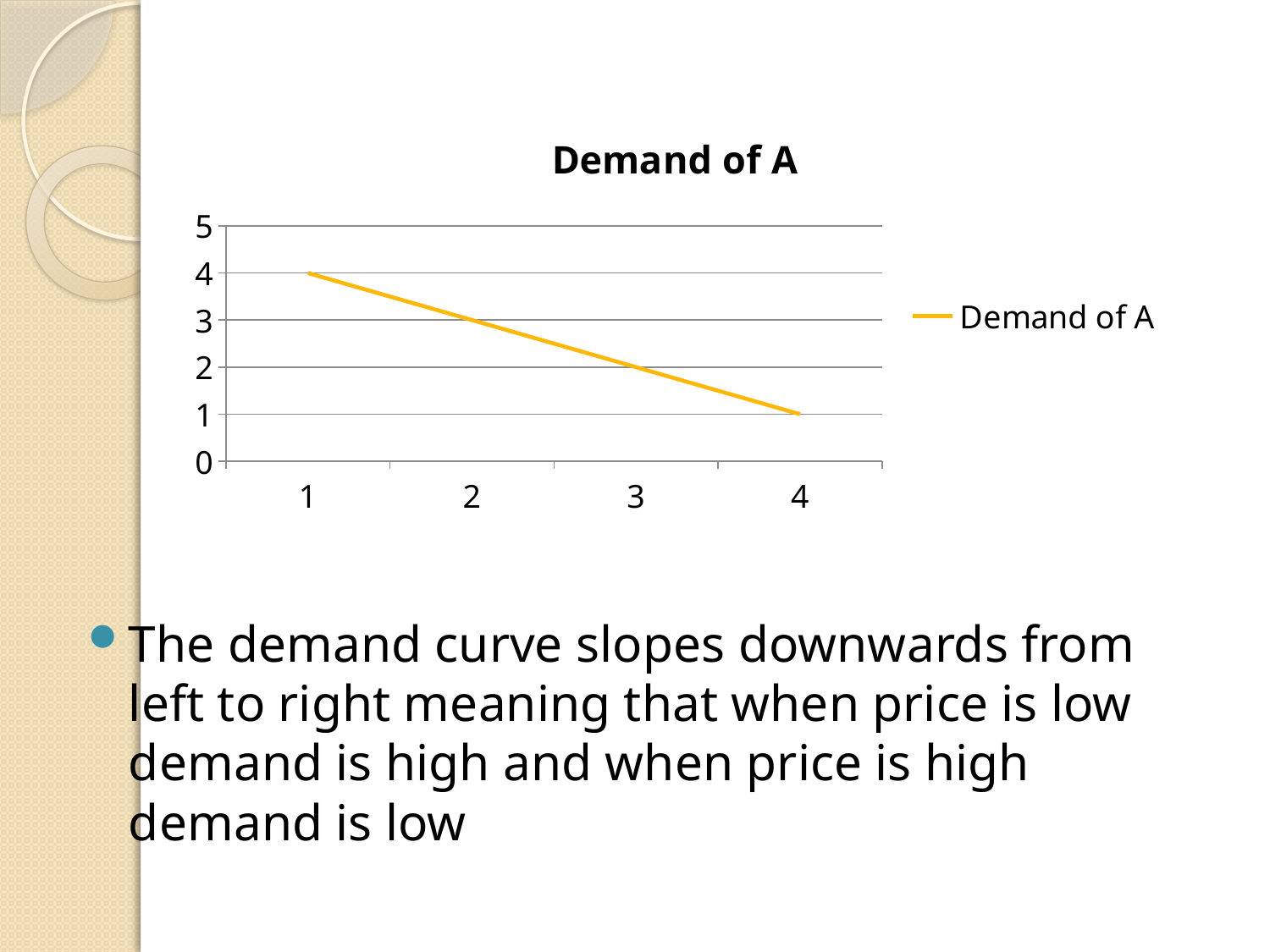
What is the value of Demand of A at x = 2? 3 What is the value of Demand of A at x = 1? 4 How many points are plotted on the Demand of A line? 4 What kind of chart is shown on the slide? line chart What is the title of the chart? Demand of A Do the values of Demand of A rise or fall as x increases from 1 to 4? fall What is the value of Demand of A at x = 4? 1 Which is larger, the value of Demand of A at x = 2 or at x = 3? x = 2 What is the difference between the value of Demand of A at x = 1 and at x = 4? 3 How many series does the legend list? 1 At which x value is Demand of A lowest? 4 At which x value is Demand of A highest? 1